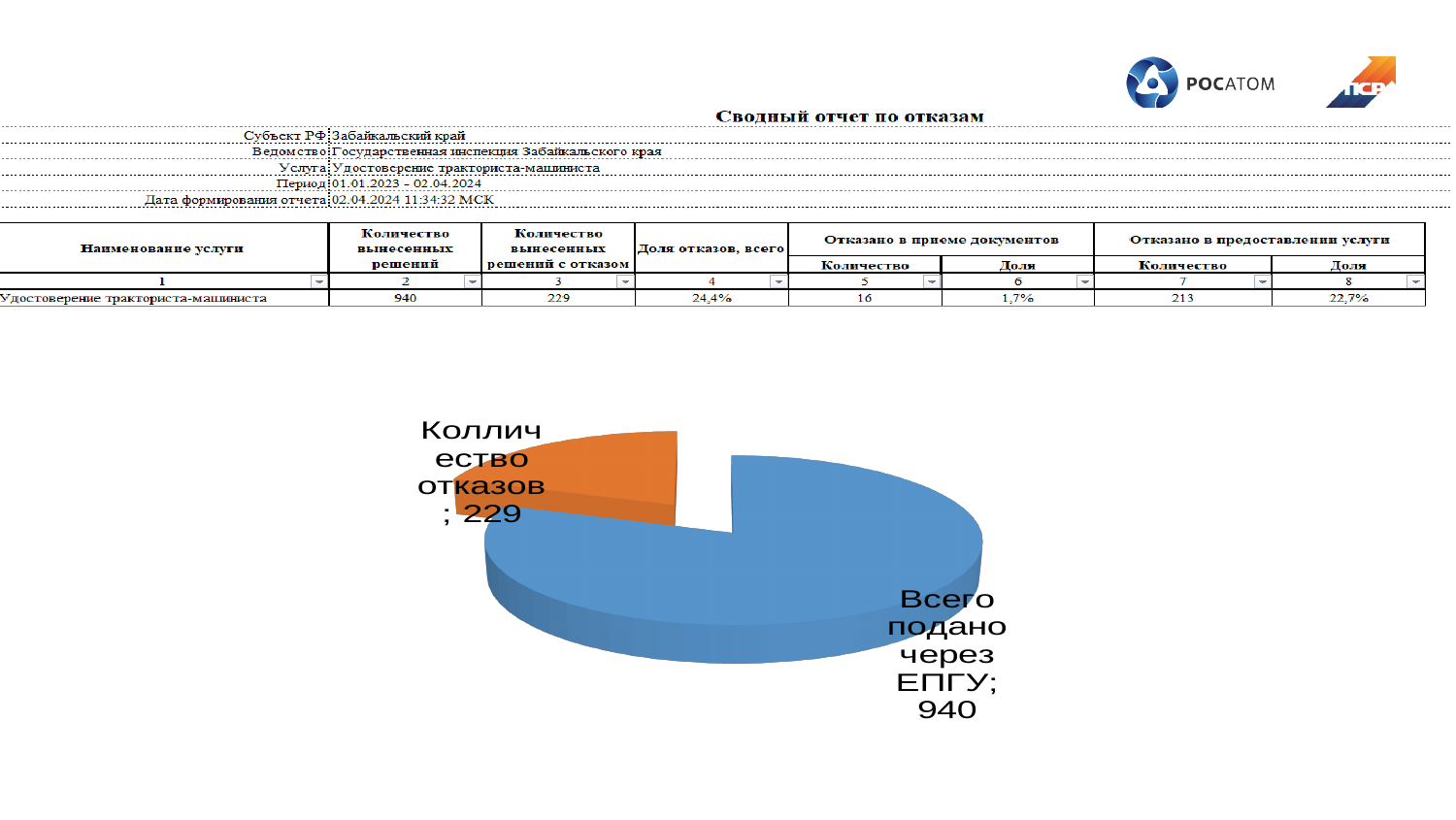
What colour is the "Колличество отказов" slice of the pie chart? Orange What is the sum of the two values shown in the pie chart? 1169 What colour is the "Всего подано через ЕПГУ" slice of the pie chart? Blue Which slice of the pie chart has the largest value? Всего подано через ЕПГУ What value is shown for the "Колличество отказов" slice of the pie chart? 229 What kind of chart is shown on the slide? Pie chart How many slices does the pie chart have? 2 Which is larger in the pie chart: "Всего подано через ЕПГУ" or "Колличество отказов"? Всего подано через ЕПГУ Which slice of the pie chart has the smallest value? Колличество отказов What value is shown for the "Всего подано через ЕПГУ" slice of the pie chart? 940 What is the difference between the "Всего подано через ЕПГУ" value and the "Колличество отказов" value in the pie chart? 711